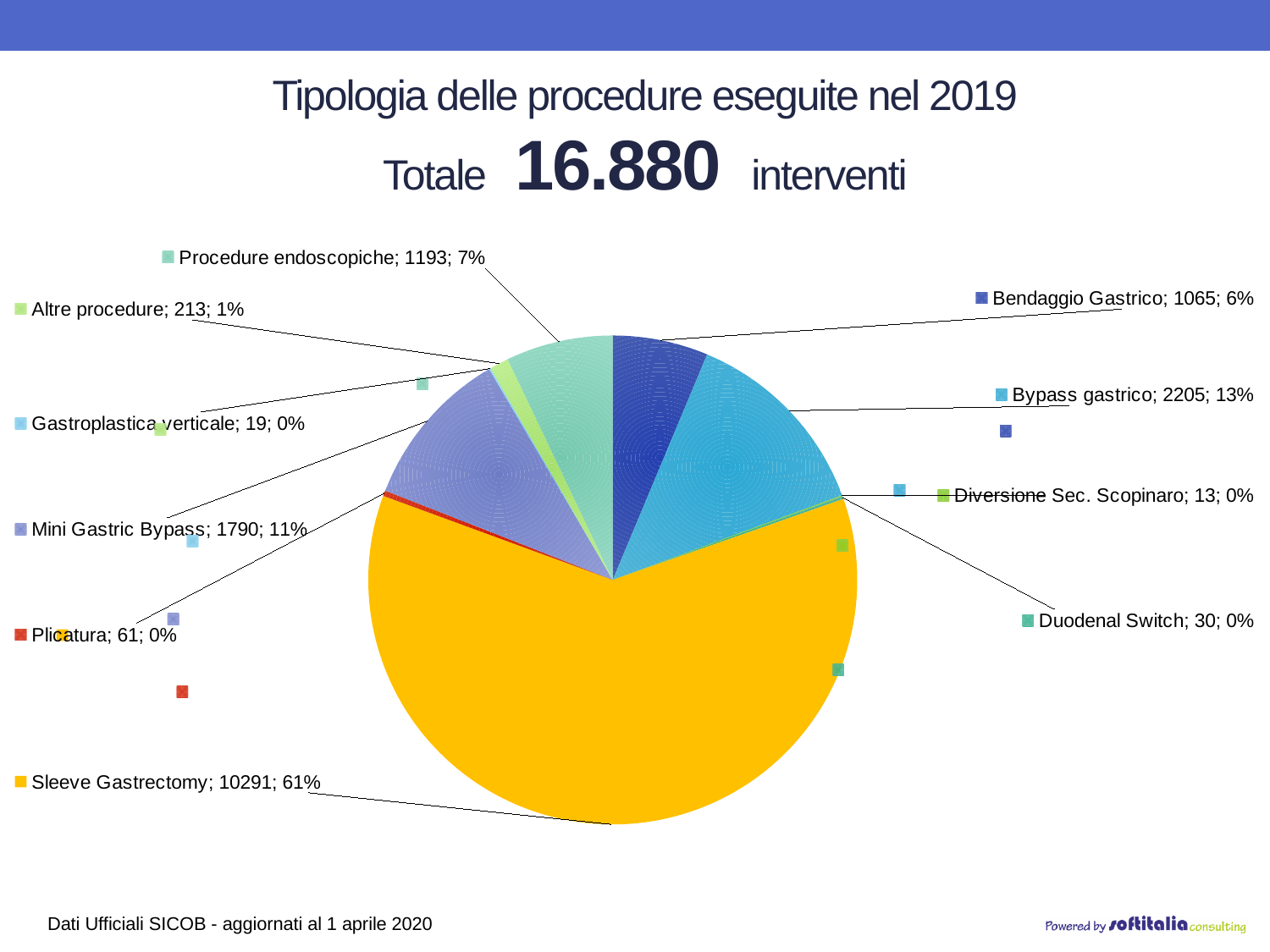
What is the value labelled for Duodenal Switch? 30 What total number of interventions is stated in the slide title? 16.880 Which has a larger value, Procedure endoscopiche or Bendaggio Gastrico? Procedure endoscopiche What percentage share is labelled for Procedure endoscopiche? 7% How many categories are shown in the pie chart? 10 How many interventions are labelled for Sleeve Gastrectomy? 10291 Which procedure has the smallest labelled value? Diversione Sec. Scopinaro Which procedure has the largest slice of the pie? Sleeve Gastrectomy What percentage share does Bypass gastrico have in the pie? 13% What type of chart is shown on the slide? pie chart How many interventions are labelled for Mini Gastric Bypass? 1790 What is the difference between the values for Bypass gastrico and Mini Gastric Bypass? 415